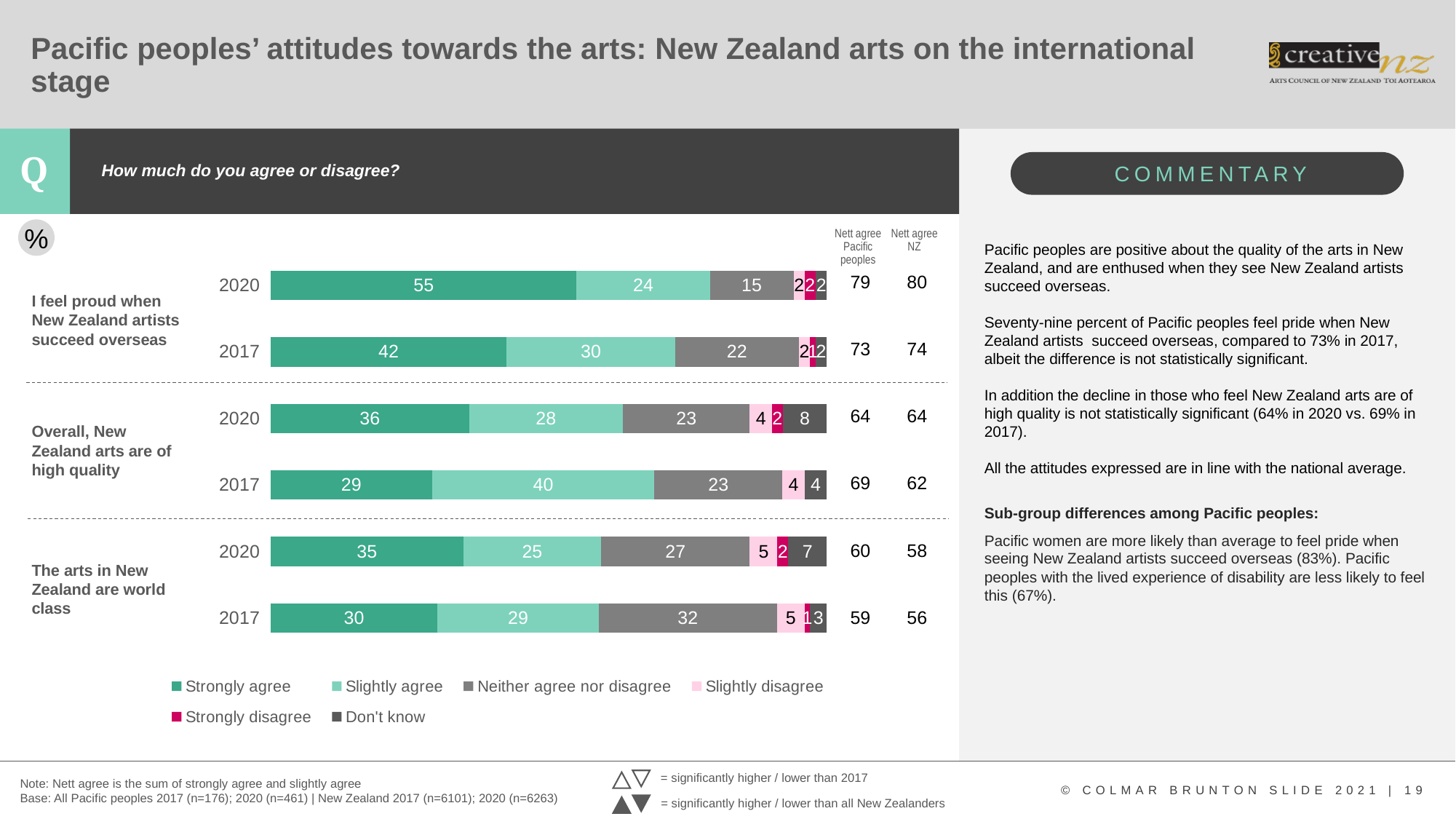
Which bar has the highest 'Strongly agree' value? I feel proud when New Zealand artists succeed overseas, 2020 Which is larger: the 'Don't know' value for 'Overall, New Zealand arts are of high quality' in 2020 or in 2017? 2020 What is the 'Slightly agree' value for 'Overall, New Zealand arts are of high quality' in 2017? 40 How many series does the legend list? 6 By how many percentage points did 'Strongly agree' for 'I feel proud when New Zealand artists succeed overseas' change from 2017 to 2020? 13 What is the Nett agree figure for Pacific peoples in 2020 for 'I feel proud when New Zealand artists succeed overseas'? 79 How many bars are plotted in the chart? 6 What type of chart is shown on the slide? Stacked bar chart What is the Nett agree NZ figure for 'The arts in New Zealand are world class' in 2017? 56 Which bar has the lowest 'Strongly agree' value? Overall, New Zealand arts are of high quality, 2017 What percentage of Pacific peoples strongly agreed in 2020 that they feel proud when New Zealand artists succeed overseas? 55 What is the 'Neither agree nor disagree' value for 'The arts in New Zealand are world class' in 2017? 32